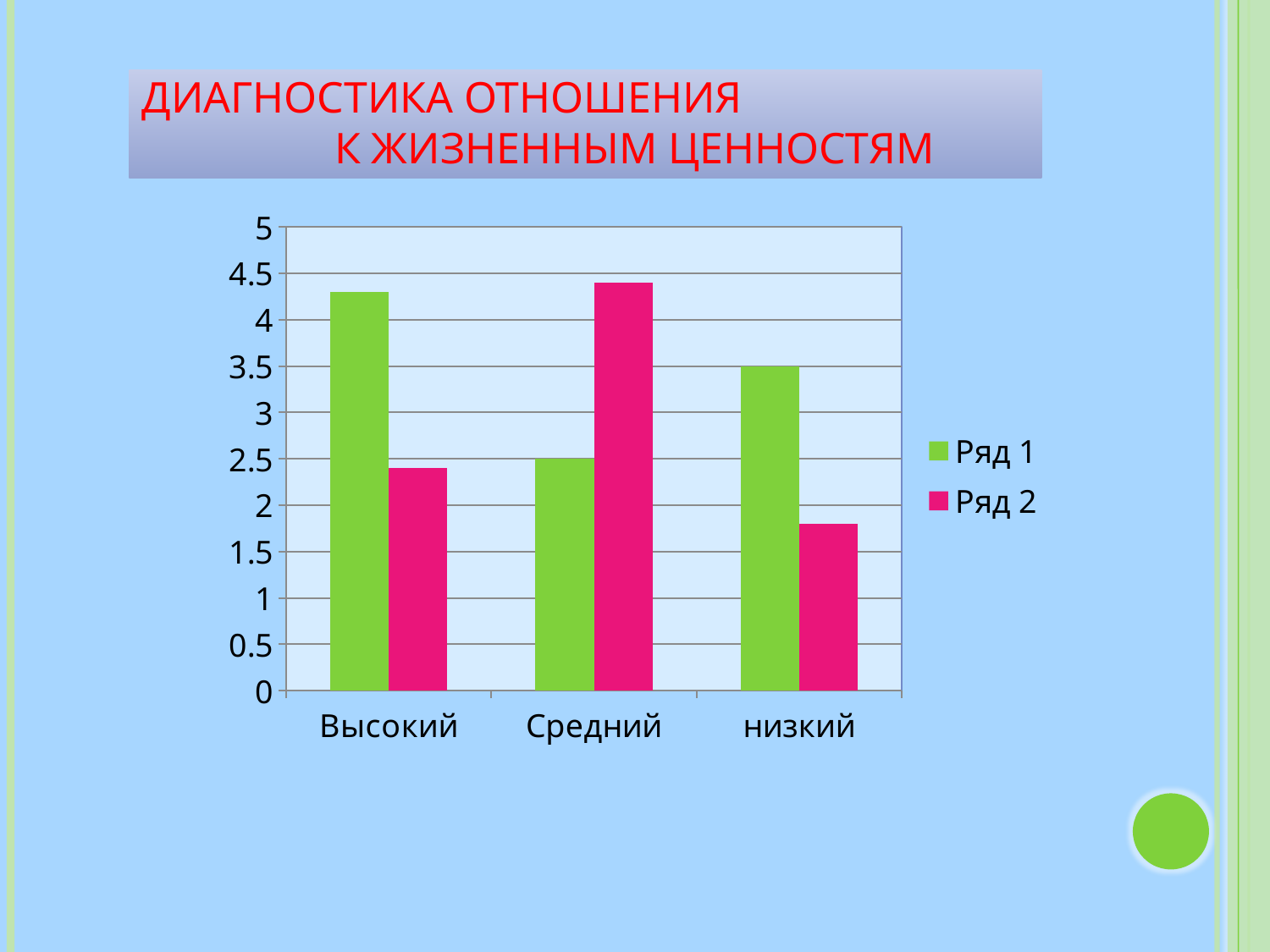
Which category has the highest value in series Ряд 2? Средний Which category has the lowest value in series Ряд 2? низкий Is the value for низкий in series Ряд 2 greater or less than 2? less How many series does the legend list? 2 What type of chart is shown on the slide? bar chart Is the value for Высокий in series Ряд 1 greater or less than 4? greater For Высокий, which series has the larger value, Ряд 1 or Ряд 2? Ряд 1 How many categories are shown on the x axis? 3 Which category has the highest value in series Ряд 1? Высокий What is the value for низкий in series Ряд 1? 3.5 What colour are the bars for series Ряд 2? pink What is the value for Средний in series Ряд 1? 2.5